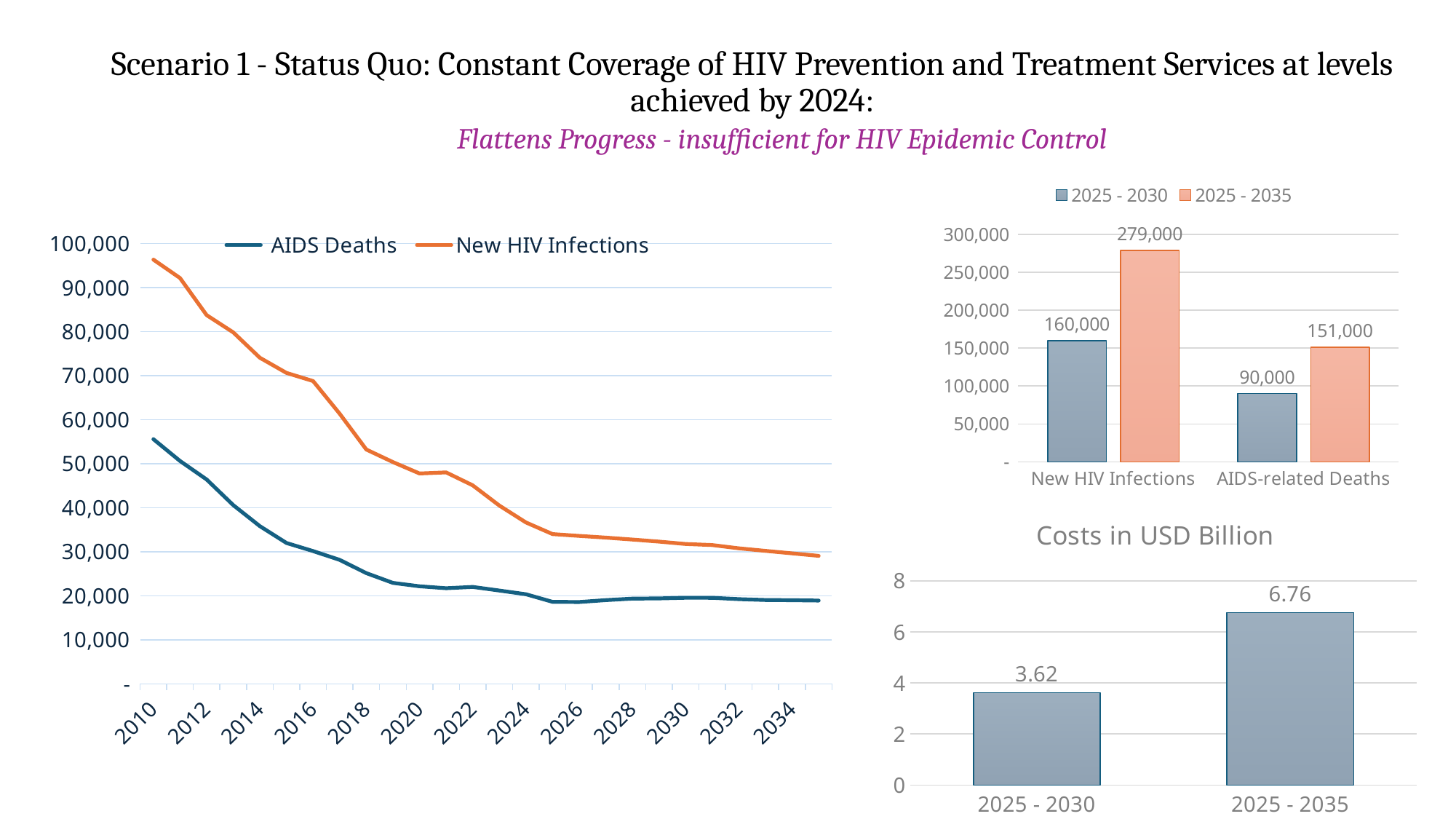
In the 'Costs in USD Billion' chart, what is the difference between the 2025 - 2035 and 2025 - 2030 values? 3.14 What kind of chart is the chart on the left of the slide? Line chart In the top-right bar chart, what is the value for AIDS-related Deaths in the 2025 - 2030 series? 90,000 In the top-right bar chart, which bar has the highest value? New HIV Infections, 2025 - 2035 In the 'Costs in USD Billion' chart, what is the value for 2025 - 2035? 6.76 In the left line chart, is the value for AIDS Deaths in 2010 greater or less than 50,000? greater In the left line chart, does the New HIV Infections line rise or fall from 2010 to 2034? Fall In the top-right bar chart, what is the value for New HIV Infections in the 2025 - 2035 series? 279,000 In the 'Costs in USD Billion' chart, what is the value for 2025 - 2030? 3.62 In the left line chart, which series has the higher value in 2020, AIDS Deaths or New HIV Infections? New HIV Infections How many series does the legend of the top-right bar chart list? 2 In the top-right bar chart, what is the difference between the 2025 - 2035 and 2025 - 2030 values for AIDS-related Deaths? 61,000